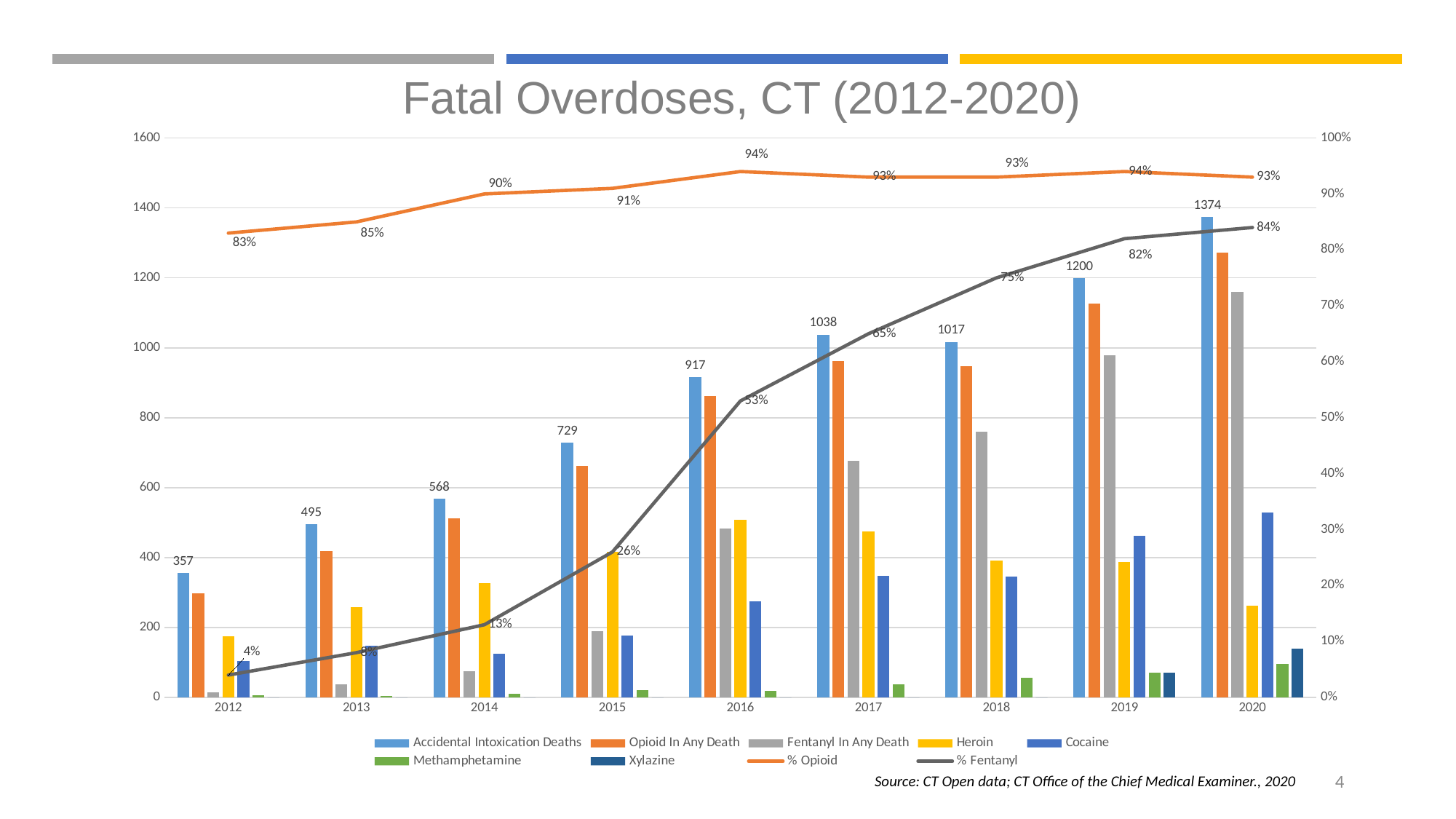
What is the % Opioid value for 2012? 83% Which year has the highest number of Accidental Intoxication Deaths? 2020 How many years are shown on the x axis? 9 What is the value of Accidental Intoxication Deaths in 2020? 1374 How many series does the legend list? 9 Is the value for Opioid In Any Death in 2020 greater or less than 1200? greater What is the % Fentanyl value for 2016? 53% Does the % Fentanyl line rise or fall from 2012 to 2020? Rises What is the difference in Accidental Intoxication Deaths between 2020 and 2019? 174 Which year has the lowest number of Accidental Intoxication Deaths? 2012 Which year had more Accidental Intoxication Deaths, 2017 or 2018? 2017 What kind of chart is shown on the slide? Combined bar and line chart